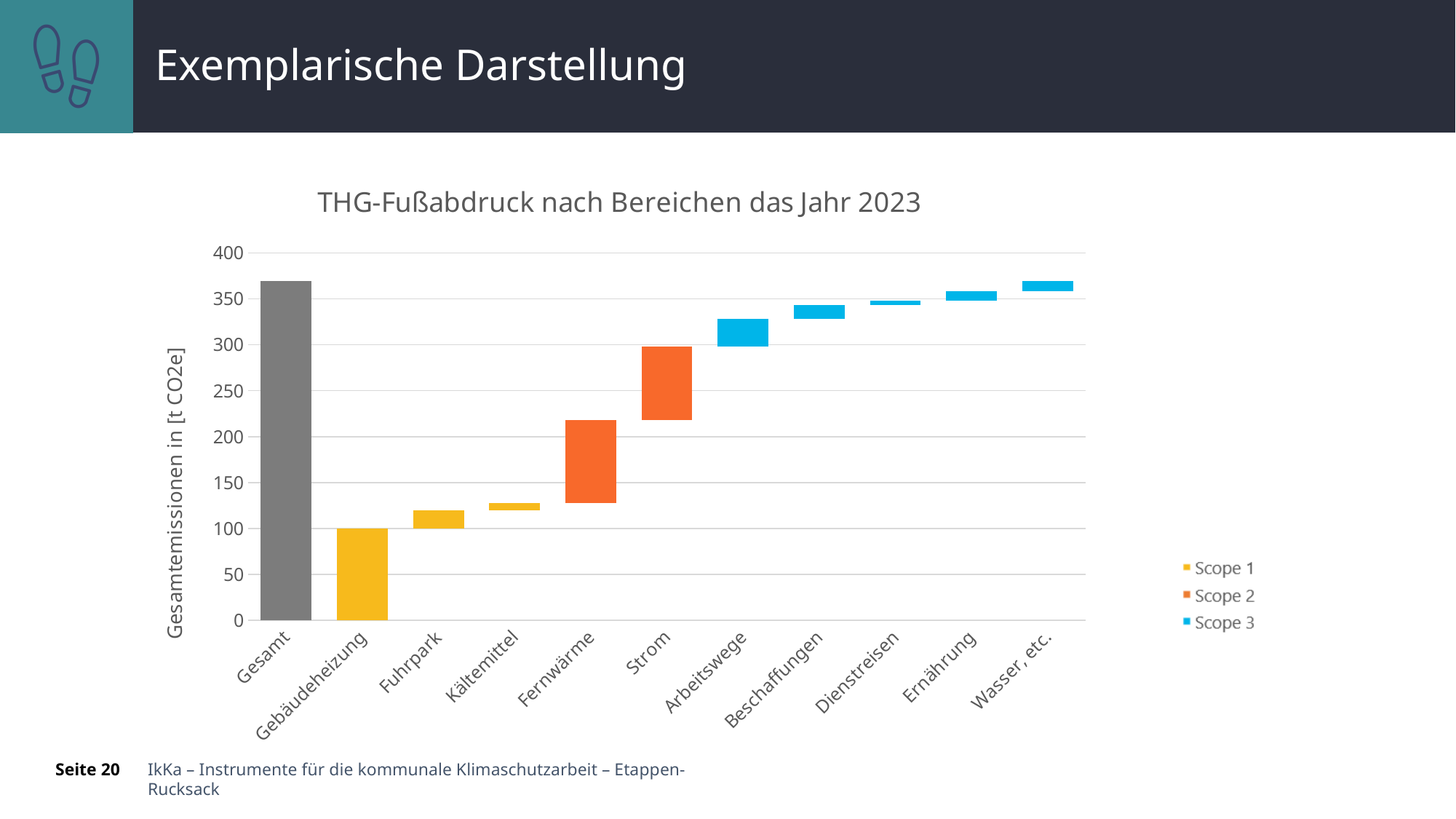
Which is larger, the segment for Fernwärme or the segment for Kältemittel? Fernwärme How many categories belong to Scope 3 according to the colouring? 5 Which Scope 1 category has the largest segment? Gebäudeheizung Is the value for Gesamt greater or less than 400? less What is the title of the chart? THG-Fußabdruck nach Bereichen das Jahr 2023 What kind of chart is shown on the slide? Bar chart (waterfall) Which is larger, the segment for Strom or the segment for Dienstreisen? Strom Is the value for Gesamt greater or less than 350? greater What is the label of the y axis? Gesamtemissionen in [t CO2e] How many categories are shown on the x axis? 11 Do the cumulative bar tops rise or fall from Gebäudeheizung to Wasser, etc.? rise How many series does the legend list? 3